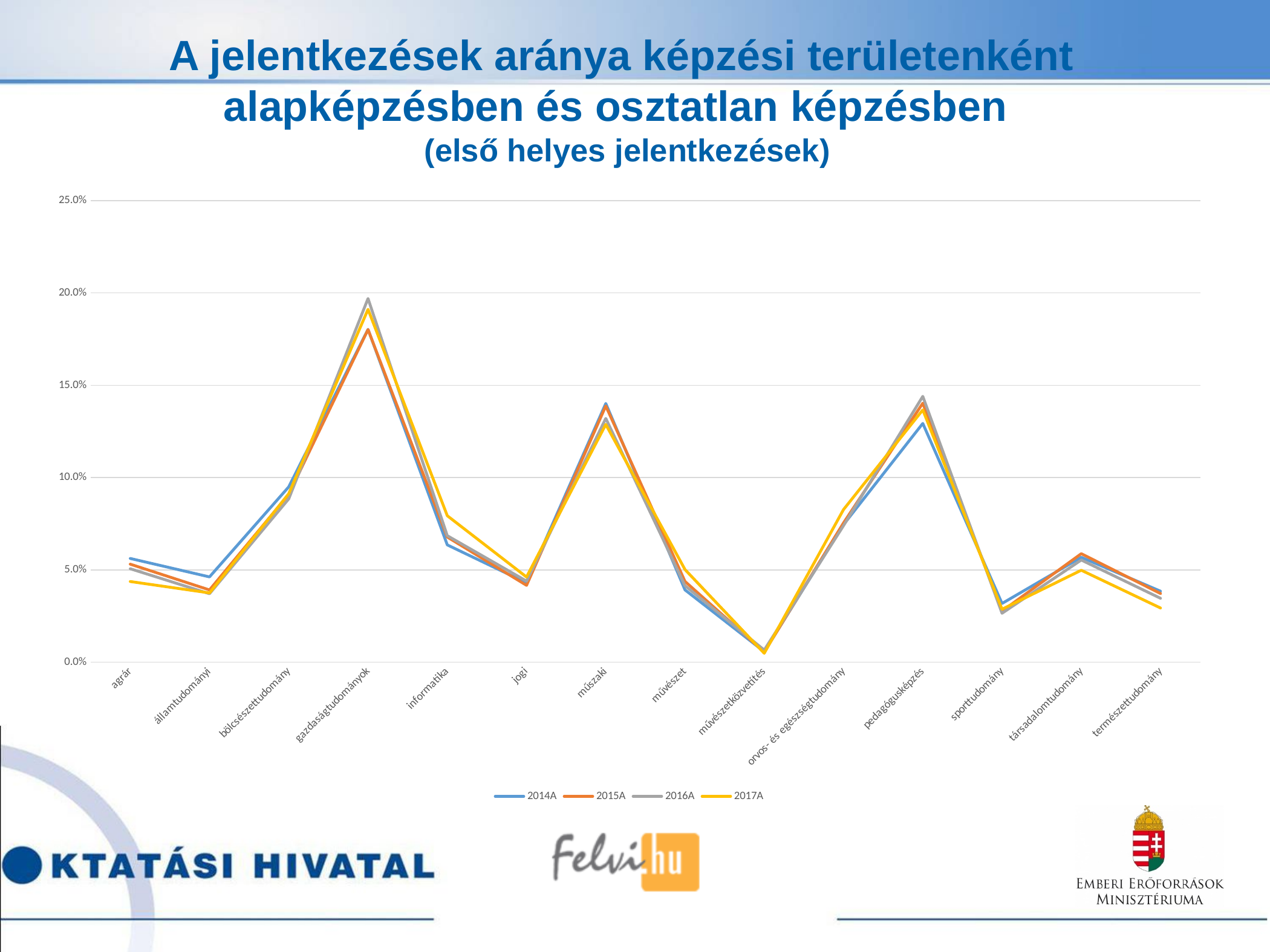
Which is larger for the 2014A series: the value for műszaki or the value for művészet? műszaki Which is larger for the 2017A series: the value for informatika or the value for jogi? informatika Is the value for gazdaságtudományok in the 2016A series greater or less than 15.0%? greater Which category has the lowest value for the 2017A series? művészetközvetítés Which series is drawn in yellow according to the legend? 2017A Is the value for pedagógusképzés in the 2016A series greater or less than 10.0%? greater Is the value for művészetközvetítés in the 2014A series greater or less than 5.0%? less How many series does the legend list? 4 What kind of chart is shown on the slide? line chart Which category has the highest value for the 2016A series? gazdaságtudományok How many categories are shown along the x axis? 14